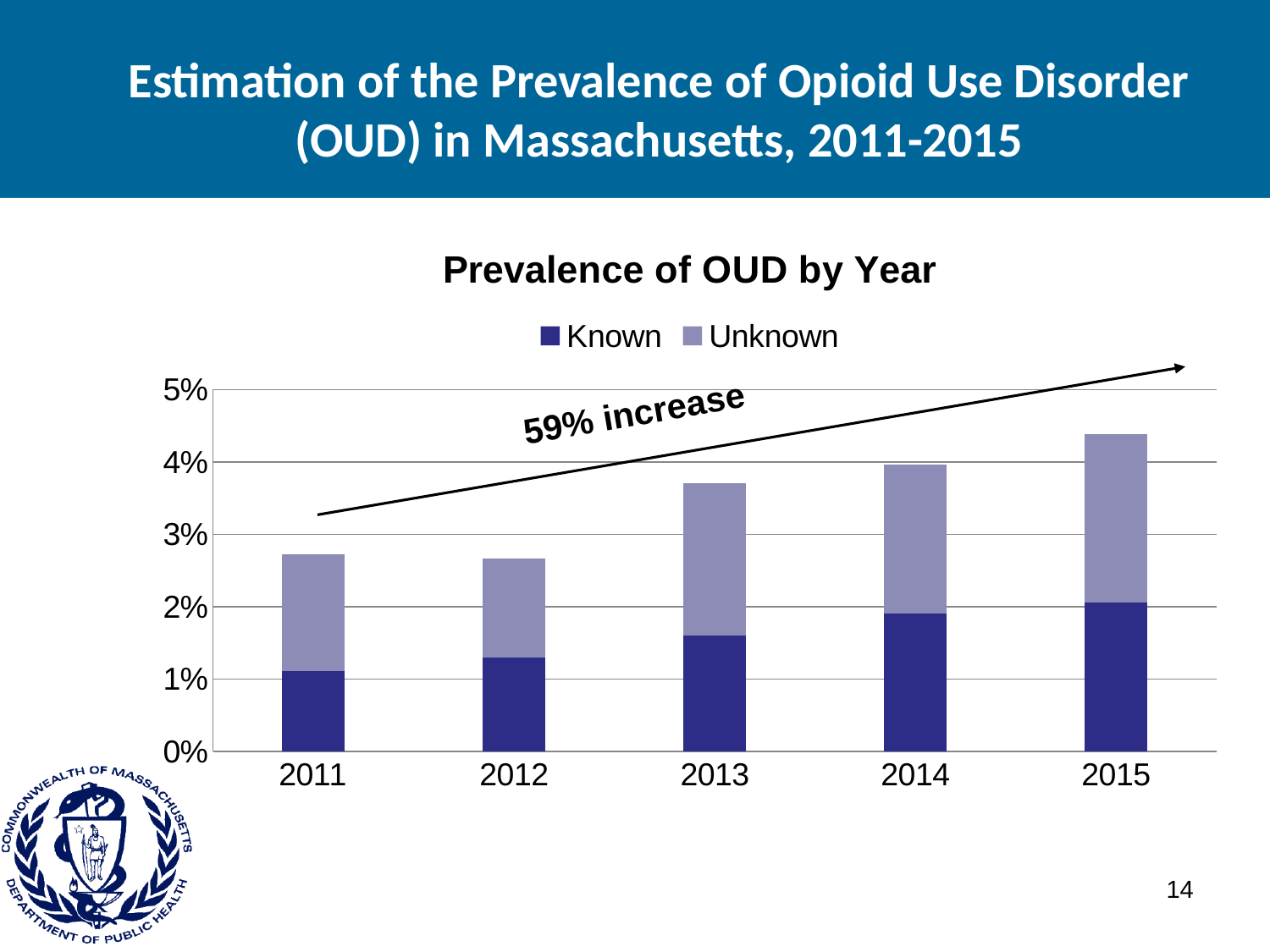
Which year has the highest total prevalence of OUD? 2015 Is the total prevalence for 2011 greater or less than 3%? less Is the total prevalence for 2013 greater or less than 3%? greater Is the Known value for 2013 greater or less than 1%? greater What kind of chart is shown on the slide? Stacked bar chart Do the total prevalence values generally rise or fall from 2011 to 2015? rise Which is larger, the Known value for 2013 or the Known value for 2015? 2015 How many years are shown on the x axis of the chart? 5 Which year has the lowest value for the Known series? 2011 What percentage increase is annotated on the chart? 59% increase How many series does the chart legend list? 2